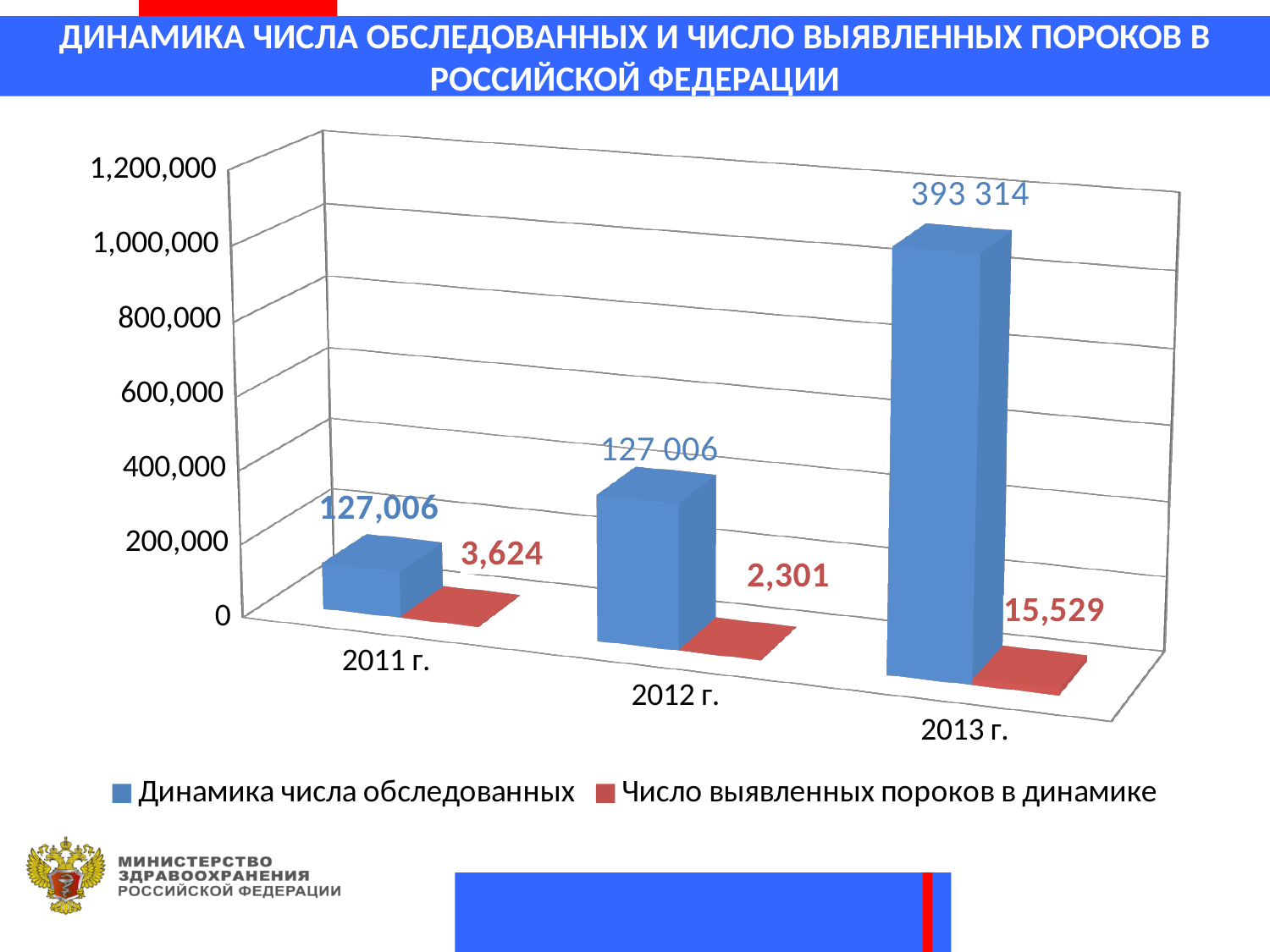
How many years are shown on the x axis? 3 What value is shown for Число выявленных пороков в динамике in 2012 г.? 2,301 Is the value for Число выявленных пороков в динамике in 2013 г. greater or less than 200,000? less Which year has the lowest value for Число выявленных пороков в динамике? 2012 г. What kind of chart is shown on the slide? bar chart What is the difference between the Число выявленных пороков в динамике values for 2013 г. and 2011 г.? 11,905 Which is larger: Число выявленных пороков в динамике in 2011 г. or in 2012 г.? 2011 г. What value is shown for Динамика числа обследованных in 2011 г.? 127,006 What value is shown for Число выявленных пороков в динамике in 2013 г.? 15,529 How many series does the legend list? 2 Which year has the highest value for Динамика числа обследованных? 2013 г. What value is labelled on the Динамика числа обследованных bar for 2013 г.? 393 314